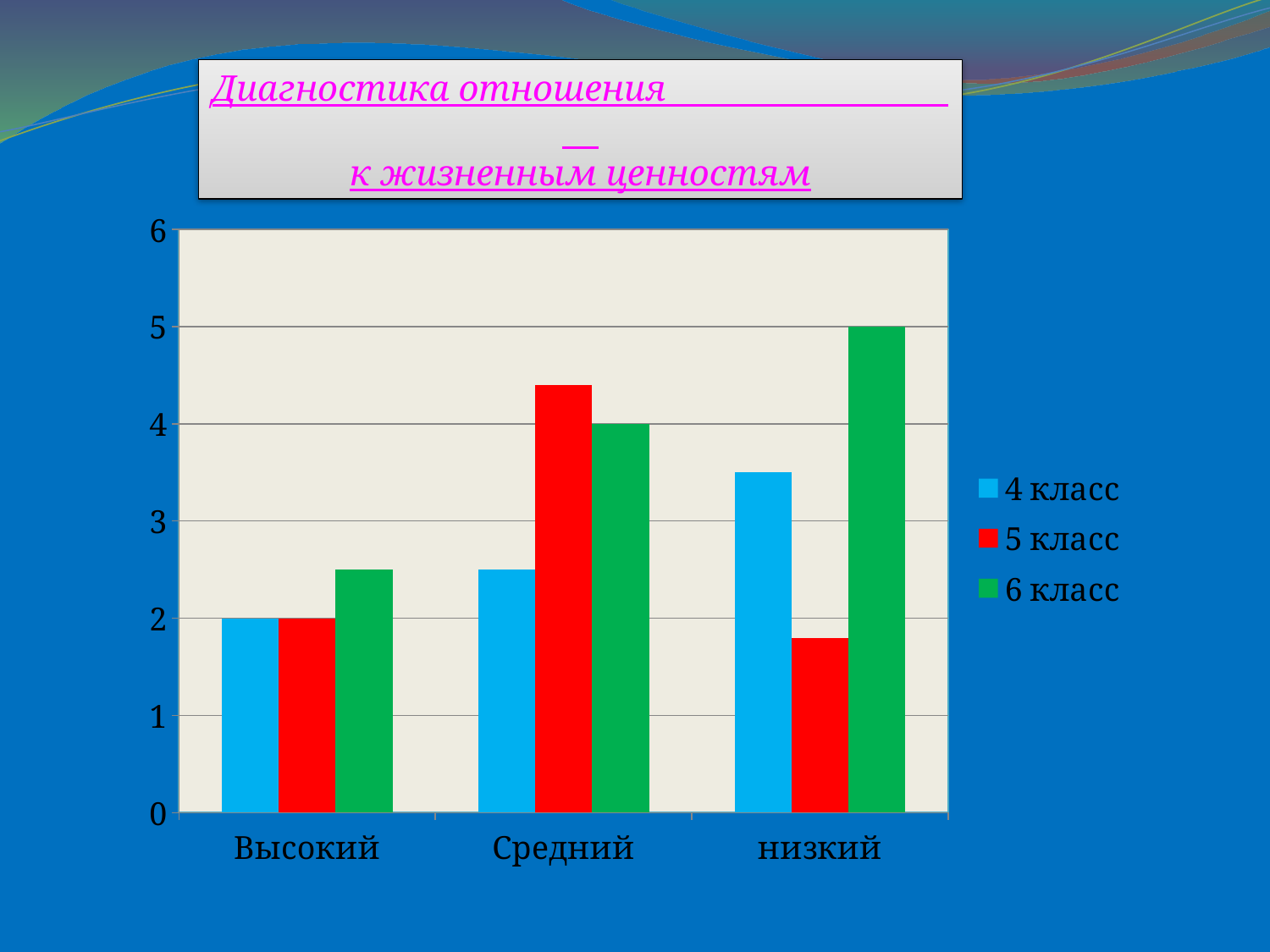
Is the value for 5 класс in the низкий category greater or less than 2? less What kind of chart is shown on the slide? bar chart Is the value for 4 класс in the низкий category greater or less than 3? greater In which category does 6 класс have its highest value? низкий Is the value for 5 класс in the Средний category greater or less than 4? greater What is the value for 4 класс in the Высокий category? 2 What is the value for 6 класс in the низкий category? 5 Which is larger in the низкий category: 4 класс or 5 класс? 4 класс What is the value for 6 класс in the Средний category? 4 Which series is shown in red in the legend? 5 класс How many series does the legend list? 3 How many categories are shown on the x axis? 3